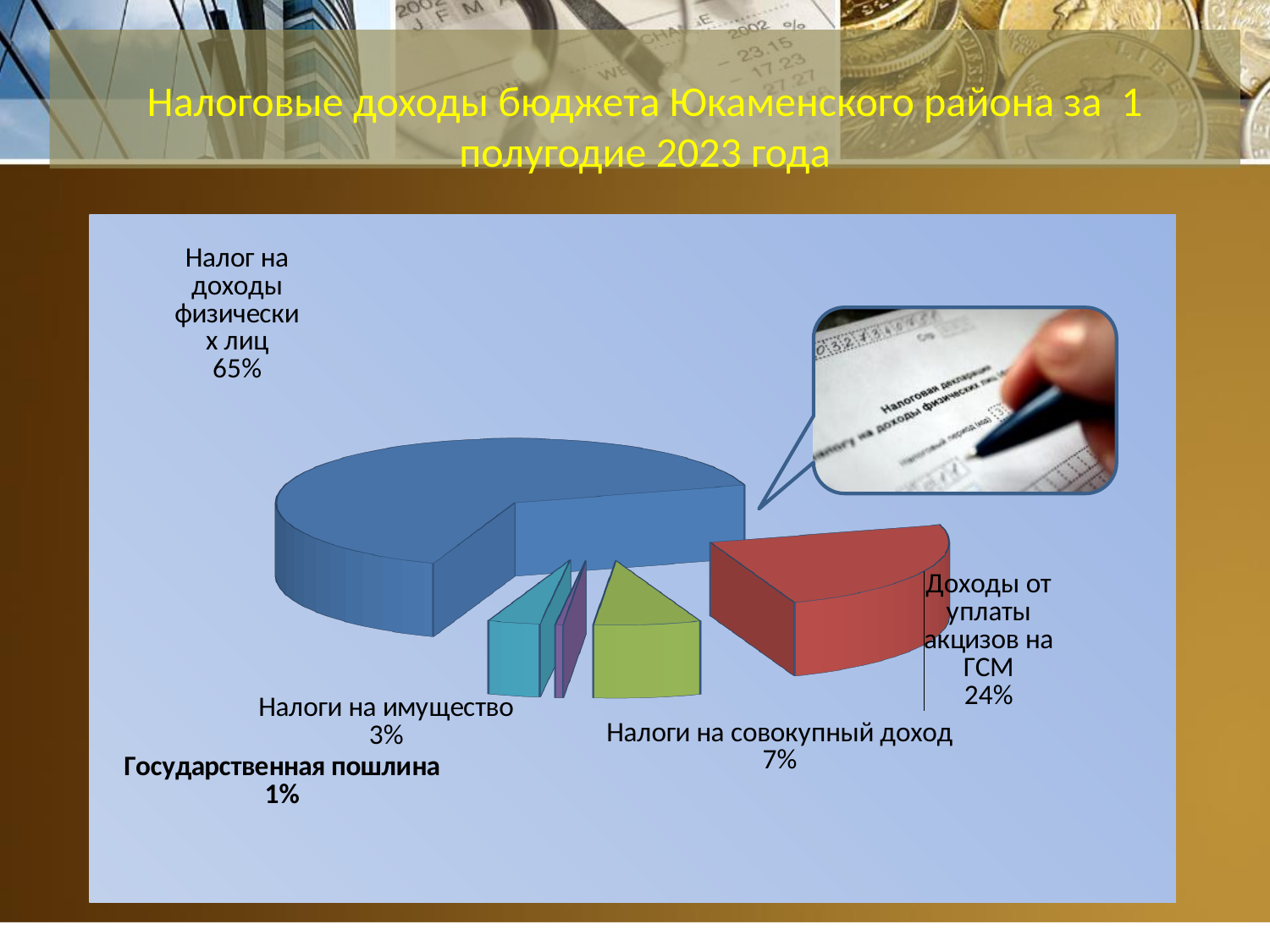
What kind of chart is shown on the slide? Pie chart What is the difference between the shares of "Налог на доходы физических лиц" and "Доходы от уплаты акцизов на ГСМ"? 41% What share of the pie does "Доходы от уплаты акцизов на ГСМ" have? 24% What is the value shown for "Налоги на имущество"? 3% Which category has the smallest slice of the pie? Государственная пошлина What is the value shown for "Налоги на совокупный доход"? 7% Which is larger: the share for "Налоги на совокупный доход" or the share for "Налоги на имущество"? Налоги на совокупный доход How many slices does the pie chart have? 5 What share of the pie does "Налог на доходы физических лиц" have? 65% What is the title of the slide containing the chart? Налоговые доходы бюджета Юкаменского района за 1 полугодие 2023 года What is the value shown for "Государственная пошлина"? 1% Which category has the largest slice of the pie? Налог на доходы физических лиц